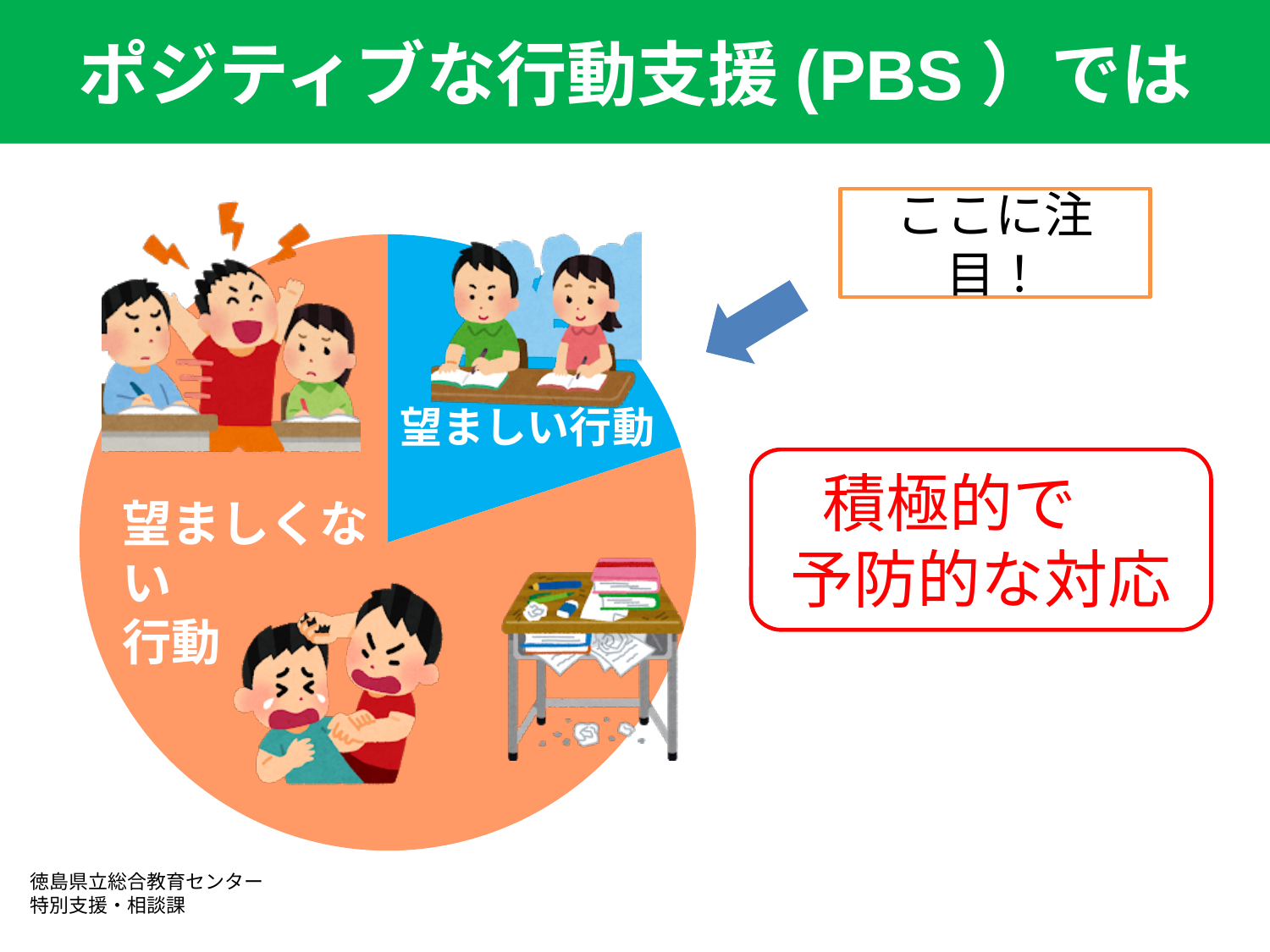
What colour is the 望ましい行動 slice of the pie chart? blue Which slice of the pie chart is the smallest? 望ましい行動 Is the share of 望ましい行動 in the pie chart greater or less than half? less Which slice of the pie chart is the largest? 望ましくない行動 What kind of chart is shown on the slide? pie chart What colour is the 望ましくない行動 slice of the pie chart? orange How many slices does the pie chart have? 2 Which slice is larger, 望ましい行動 or 望ましくない行動? 望ましくない行動 Is the share of 望ましくない行動 in the pie chart greater or less than half? greater